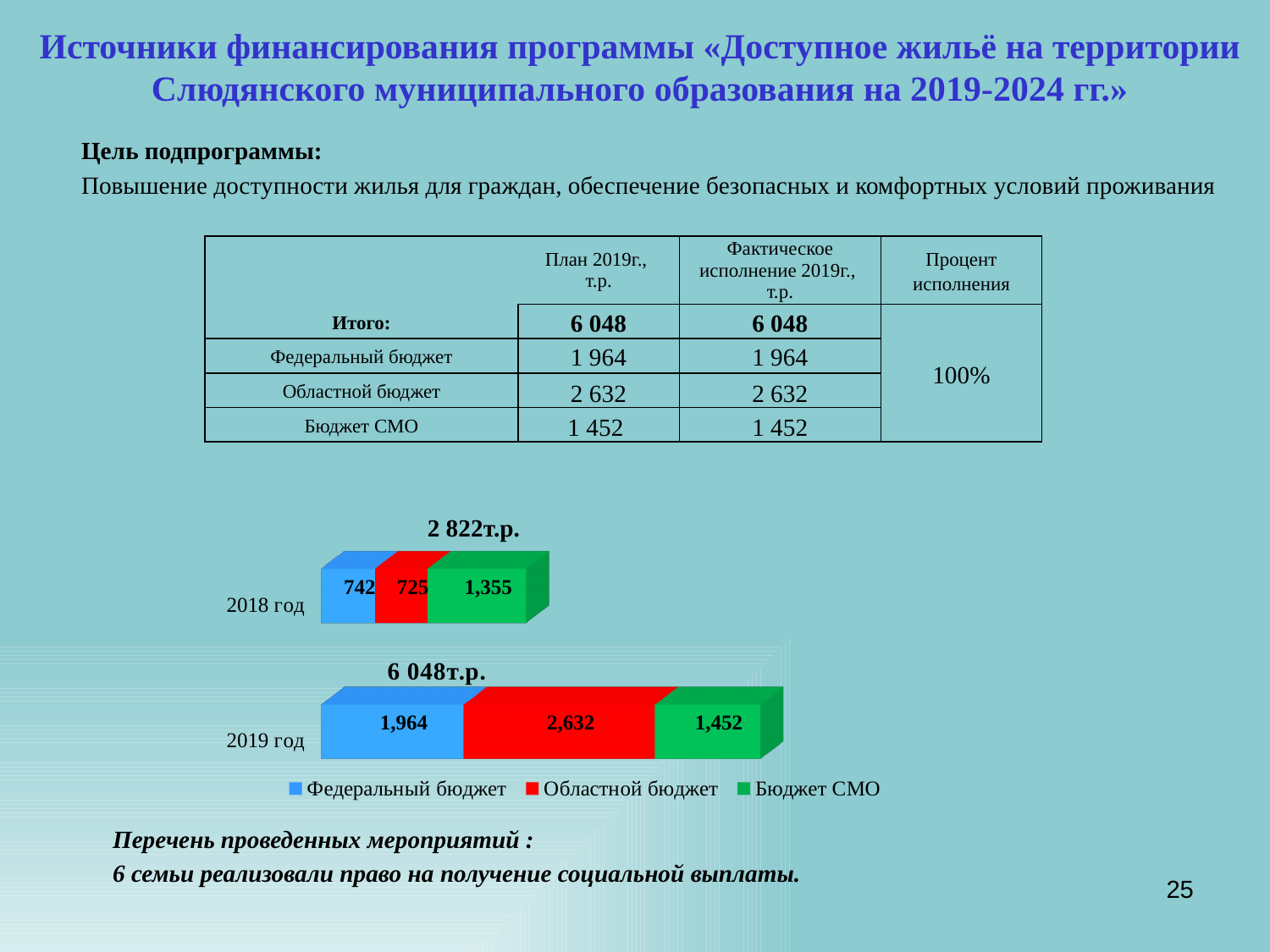
What kind of chart is shown on the slide? stacked bar chart Which series has the smallest value in 2018 год? Областной бюджет Which is larger: Федеральный бюджет in 2019 год or Бюджет СМО in 2019 год? Федеральный бюджет What is the difference between Областной бюджет in 2019 год and in 2018 год? 1,907 Which series has the largest value in 2019 год? Областной бюджет What is the total shown for the 2019 год bar? 6 048т.р. What is the total shown for the 2018 год bar? 2 822т.р. How many series does the chart legend list? 3 What is the value for Областной бюджет in 2018 год? 725 What is the value for Бюджет СМО in 2019 год? 1,452 What is the value for Федеральный бюджет in 2019 год? 1,964 How many categories (years) are plotted in the chart? 2